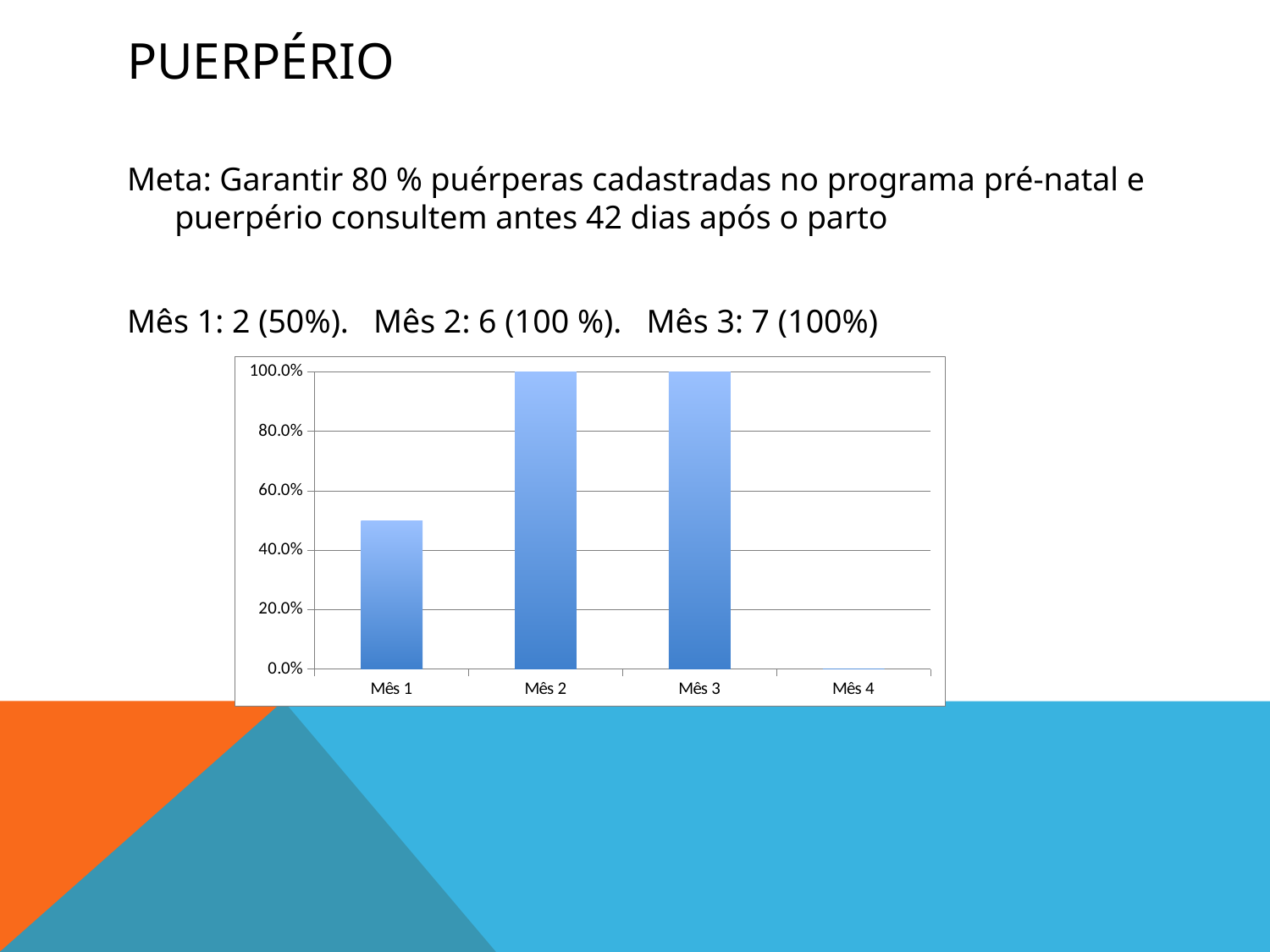
What is the value for Mês 3 in the chart? 100% Is the value for Mês 3 greater or less than 80.0%? greater What is the value for Mês 2 in the chart? 100.0% What kind of chart is shown on the slide? bar chart What is the value for Mês 1 in the chart? 50% Which is larger, the value for Mês 1 or the value for Mês 2? Mês 2 Is the value for Mês 1 greater or less than 80.0%? less Does the value rise or fall from Mês 1 to Mês 2? rise What is the difference between the value for Mês 2 and the value for Mês 1? 50% How many categories are shown on the x axis of the chart? 4 Which category has the lowest value in the chart? Mês 4 What is the value for Mês 4 in the chart? 0.0%